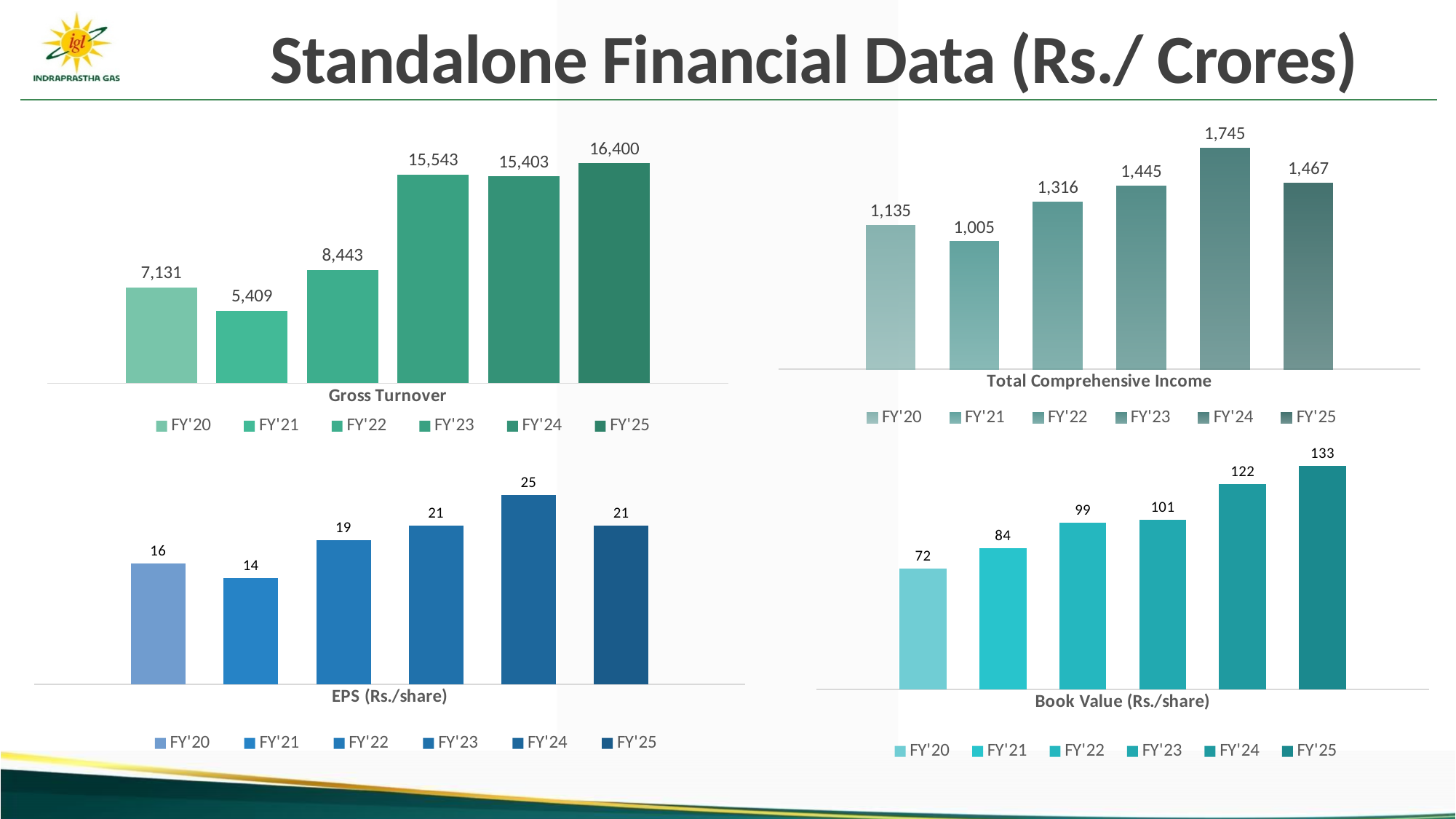
What kind of chart is the EPS (Rs./share) chart? bar chart In the EPS (Rs./share) chart, which is larger, FY'20 or FY'21? FY'20 In the Gross Turnover chart, which fiscal year has the lowest value? FY'21 In the Book Value (Rs./share) chart, what is the value for FY'20? 72 In the Total Comprehensive Income chart, which fiscal year has the highest value? FY'24 In the Total Comprehensive Income chart, what is the difference between FY'24 and FY'25? 278 How many bars are in the Book Value (Rs./share) chart? 6 In the Gross Turnover chart, what is the value for FY'25? 16,400 In the EPS (Rs./share) chart, what is the value for FY'24? 25 In the Gross Turnover chart, what is the difference between FY'23 and FY'22? 7,100 In the Book Value (Rs./share) chart, do the values rise or fall from FY'20 to FY'25? rise In the Total Comprehensive Income chart, what is the value for FY'22? 1,316